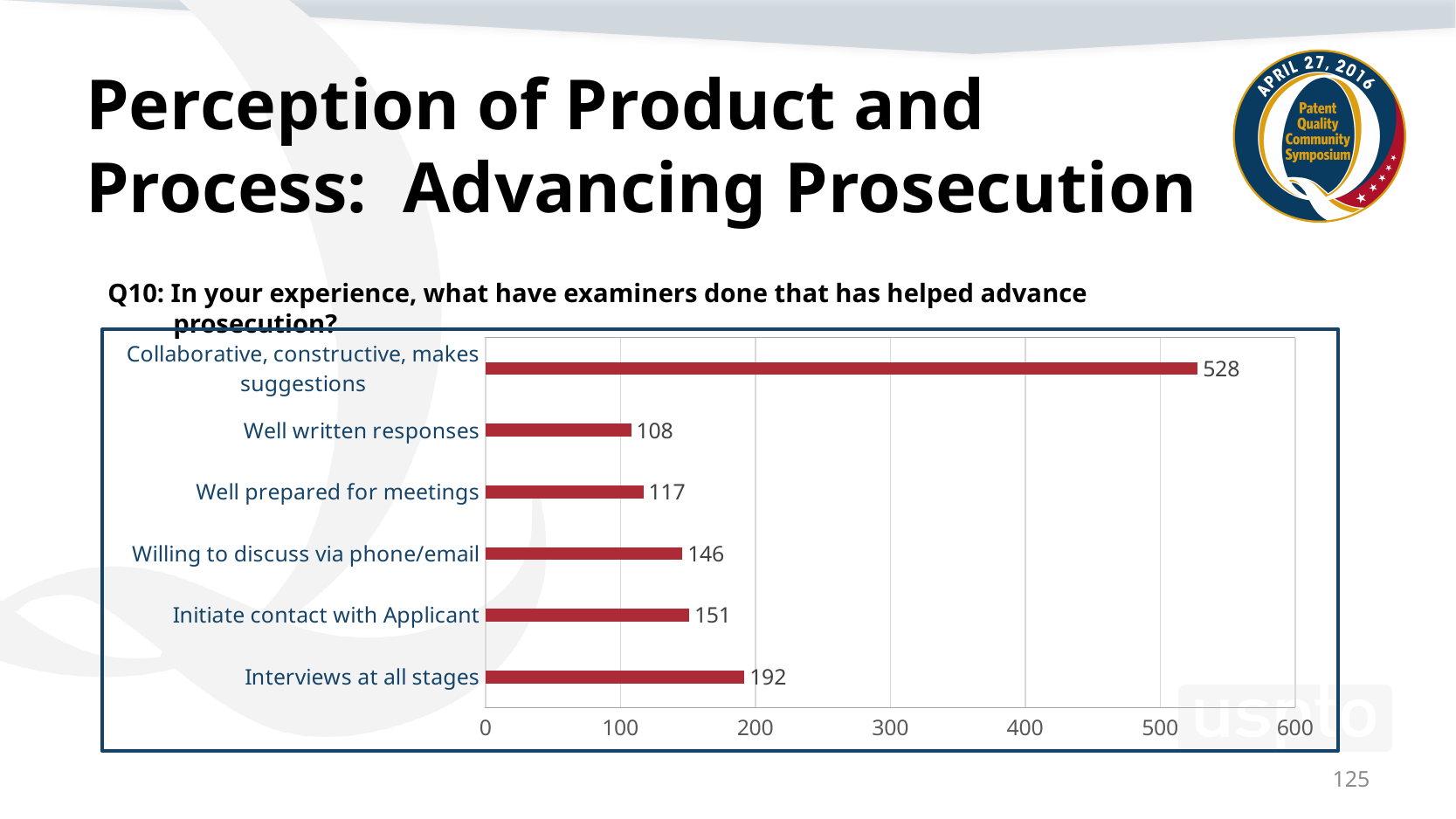
What is the value for "Interviews at all stages"? 192 What is the value for "Willing to discuss via phone/email"? 146 Is the value for "Well prepared for meetings" greater or less than 200? less How many categories are shown in the chart? 6 What is the difference between the values for "Initiate contact with Applicant" and "Well prepared for meetings"? 34 Which category has the highest value? Collaborative, constructive, makes suggestions Which is larger, the value for "Interviews at all stages" or the value for "Initiate contact with Applicant"? Interviews at all stages What is the value for "Collaborative, constructive, makes suggestions"? 528 What is the difference between the values for "Collaborative, constructive, makes suggestions" and "Interviews at all stages"? 336 What is the value for "Well written responses"? 108 Which category has the lowest value? Well written responses What kind of chart is shown on the slide? bar chart